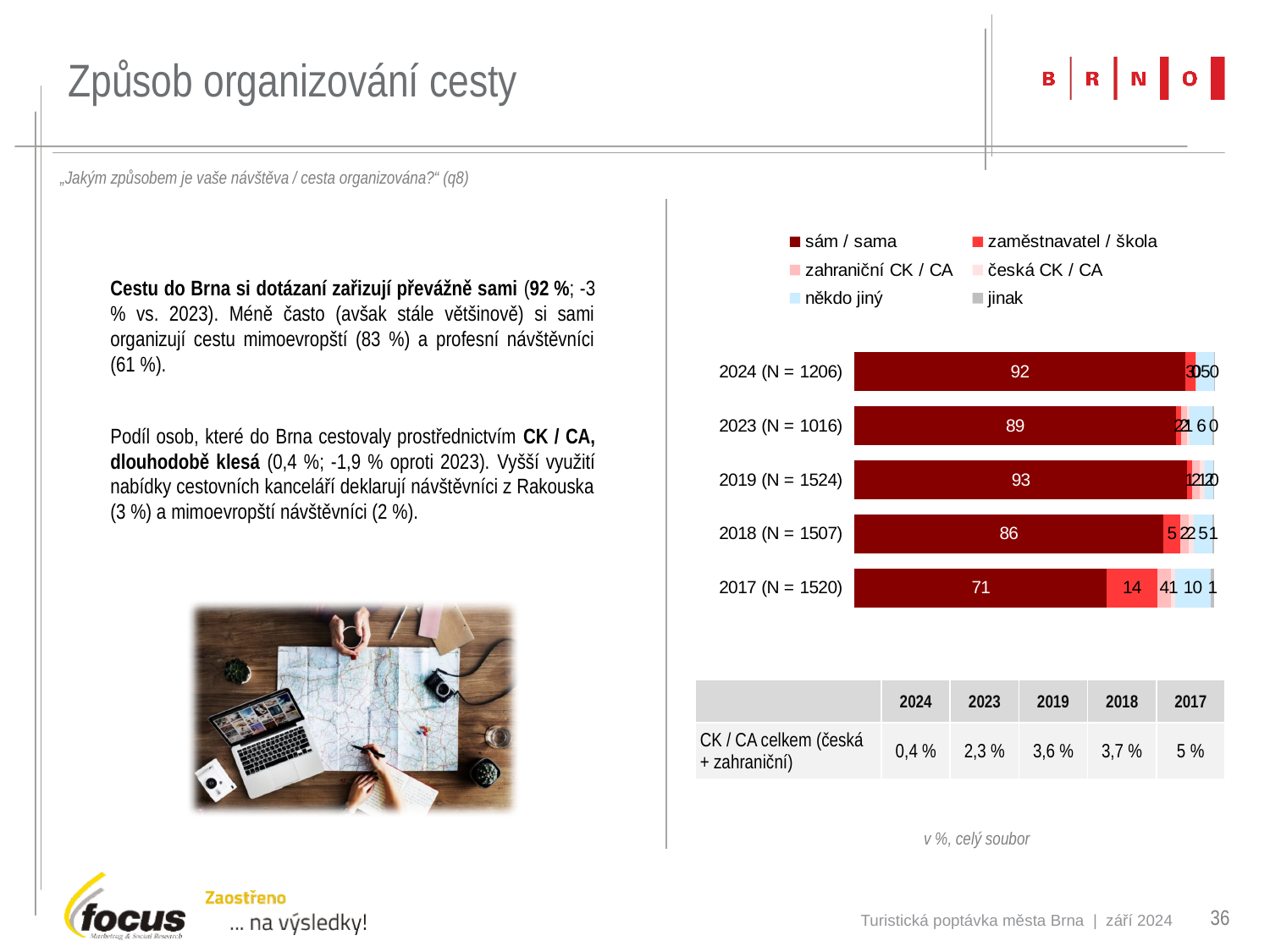
What is the difference between the "sám / sama" values for 2024 and 2023? 3 What is the value for "sám / sama" in the 2024 (N = 1206) bar? 92 How many years (bars) are shown in the chart? 5 What is the value for "sám / sama" in the 2019 (N = 1524) bar? 93 Which year has a larger "sám / sama" value, 2019 or 2018? 2019 Which year has the lowest value for "sám / sama"? 2017 (N = 1520) What is the value for "sám / sama" in the 2017 (N = 1520) bar? 71 What is the value for "sám / sama" in the 2023 (N = 1016) bar? 89 Which year has the highest value for "sám / sama"? 2019 (N = 1524) What kind of chart is shown on the slide? Stacked bar chart How many series does the chart legend list? 6 What is the value for "zaměstnavatel / škola" in the 2017 (N = 1520) bar? 14